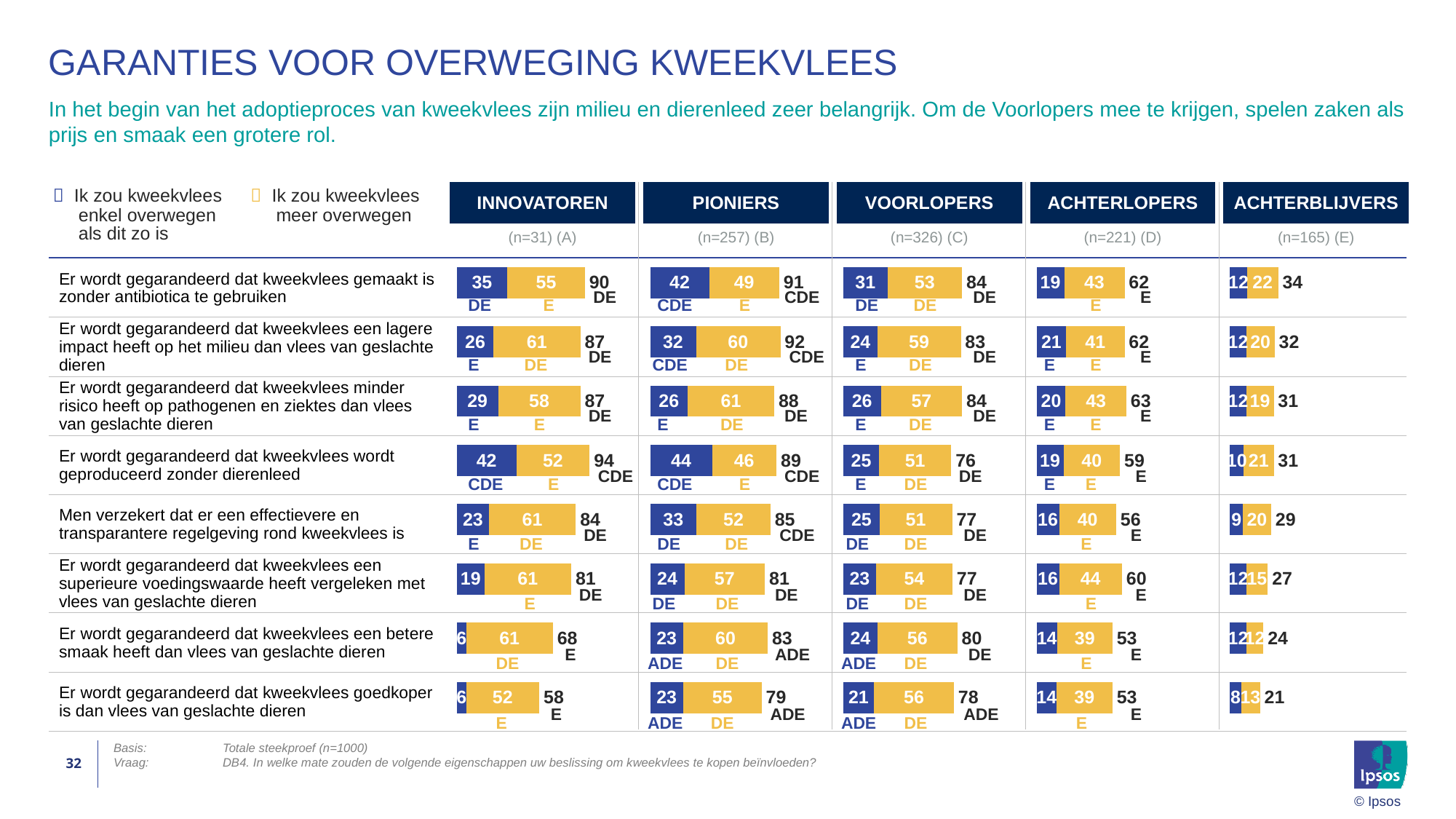
What kind of chart is used for each segment on this slide? Stacked bar chart How many statements (rows) are shown in each chart? 8 In the ACHTERBLIJVERS chart, which statement has the lowest total? Er wordt gegarandeerd dat kweekvlees goedkoper is dan vlees van geslachte dieren In the VOORLOPERS chart, what is the 'Ik zou kweekvlees meer overwegen' value for 'Er wordt gegarandeerd dat kweekvlees een lagere impact heeft op het milieu dan vlees van geslachte dieren'? 59 How many series does the legend list? 2 In the ACHTERLOPERS chart, what is the difference between the totals for 'zonder antibiotica' (62) and 'goedkoper' (53)? 9 In the ACHTERBLIJVERS chart, what is the 'Ik zou kweekvlees enkel overwegen als dit zo is' value for 'Men verzekert dat er een effectievere en transparantere regelgeving rond kweekvlees is'? 9 In the PIONIERS chart, what is the 'Ik zou kweekvlees enkel overwegen als dit zo is' value for 'Er wordt gegarandeerd dat kweekvlees gemaakt is zonder antibiotica te gebruiken'? 42 In the INNOVATOREN chart, what is the total for 'Er wordt gegarandeerd dat kweekvlees wordt geproduceerd zonder dierenleed'? 94 In the PIONIERS chart, which statement has the highest total? Er wordt gegarandeerd dat kweekvlees een lagere impact heeft op het milieu dan vlees van geslachte dieren What is the sample size (n) shown for the VOORLOPERS chart? n=326 In the INNOVATOREN chart, which is larger: the total for 'betere smaak' or the total for 'goedkoper'? betere smaak (68)